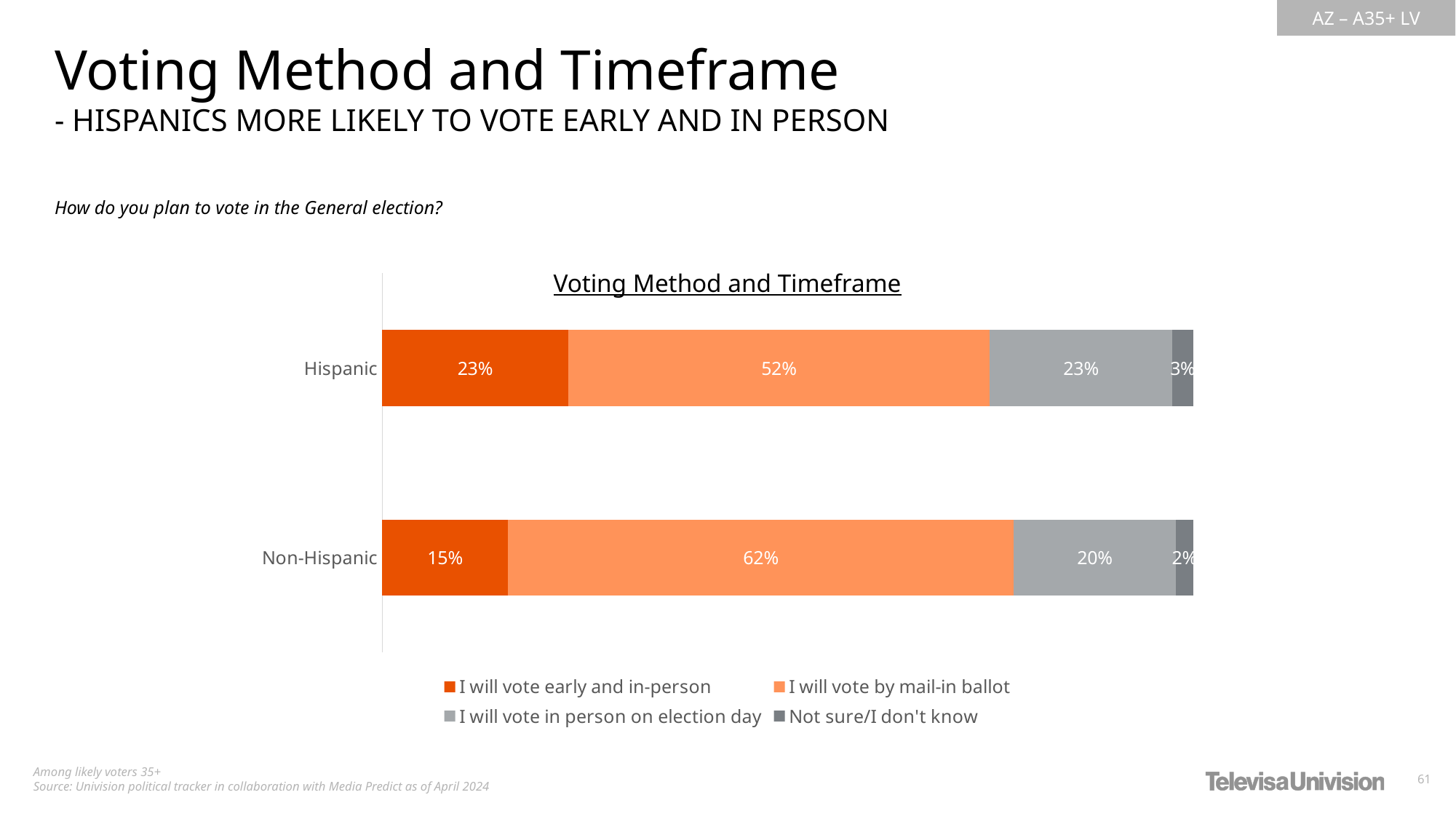
How many series does the legend list? 4 What is the difference between the Hispanic and Non-Hispanic shares for voting early and in-person? 8 percentage points What percentage of Hispanic respondents say they will vote by mail-in ballot? 52% What percentage of Non-Hispanic respondents say they will vote early and in-person? 15% Which voting method has the largest share among Hispanic respondents? I will vote by mail-in ballot What kind of chart is shown on the slide? Stacked horizontal bar chart What percentage of Hispanic respondents answered Not sure/I don't know? 3% Which group has the higher share saying they will vote by mail-in ballot, Hispanic or Non-Hispanic? Non-Hispanic How many groups (categories) are shown on the chart? 2 Which response has the smallest share among Non-Hispanic respondents? Not sure/I don't know What percentage of Non-Hispanic respondents say they will vote in person on election day? 20% What is the difference between the Non-Hispanic and Hispanic shares for voting by mail-in ballot? 10 percentage points